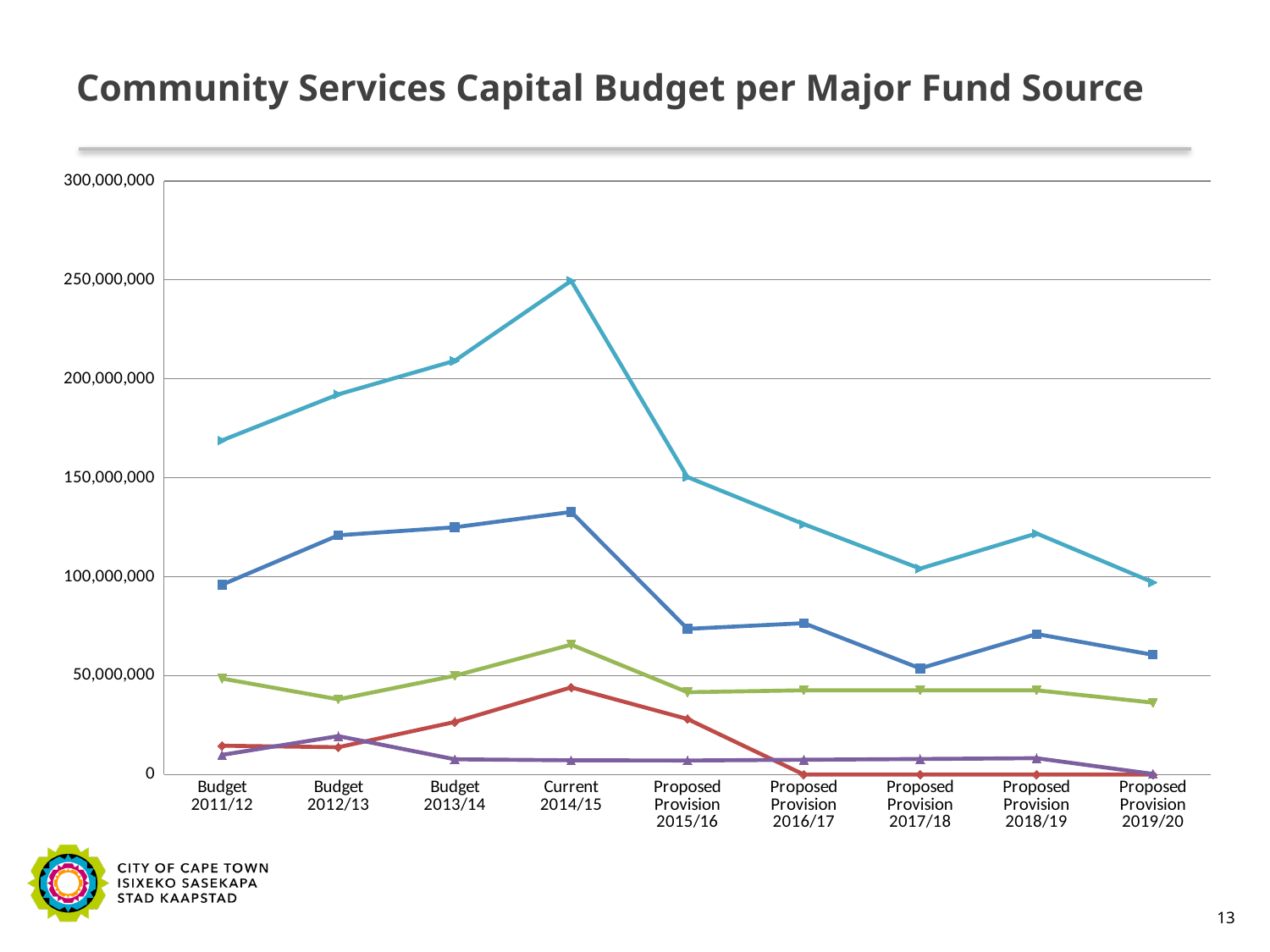
Is the value of the dark blue line at Current 2014/15 greater or less than 100,000,000? greater What is the title of the chart? Community Services Capital Budget per Major Fund Source Is the value of the light blue line at Current 2014/15 greater or less than 200,000,000? greater How many lines are plotted on the chart? 5 At Current 2014/15, which line has the larger value, the light blue line or the dark blue line? the light blue line Is the value of the green line at Current 2014/15 greater or less than 50,000,000? greater Does the light blue line rise or fall from Budget 2011/12 to Current 2014/15? rise What type of chart is shown on the slide? line chart Does the light blue line rise or fall from Current 2014/15 to Proposed Provision 2017/18? fall At which category does the light blue line reach its highest value? Current 2014/15 How many categories are shown along the x axis of the chart? 9